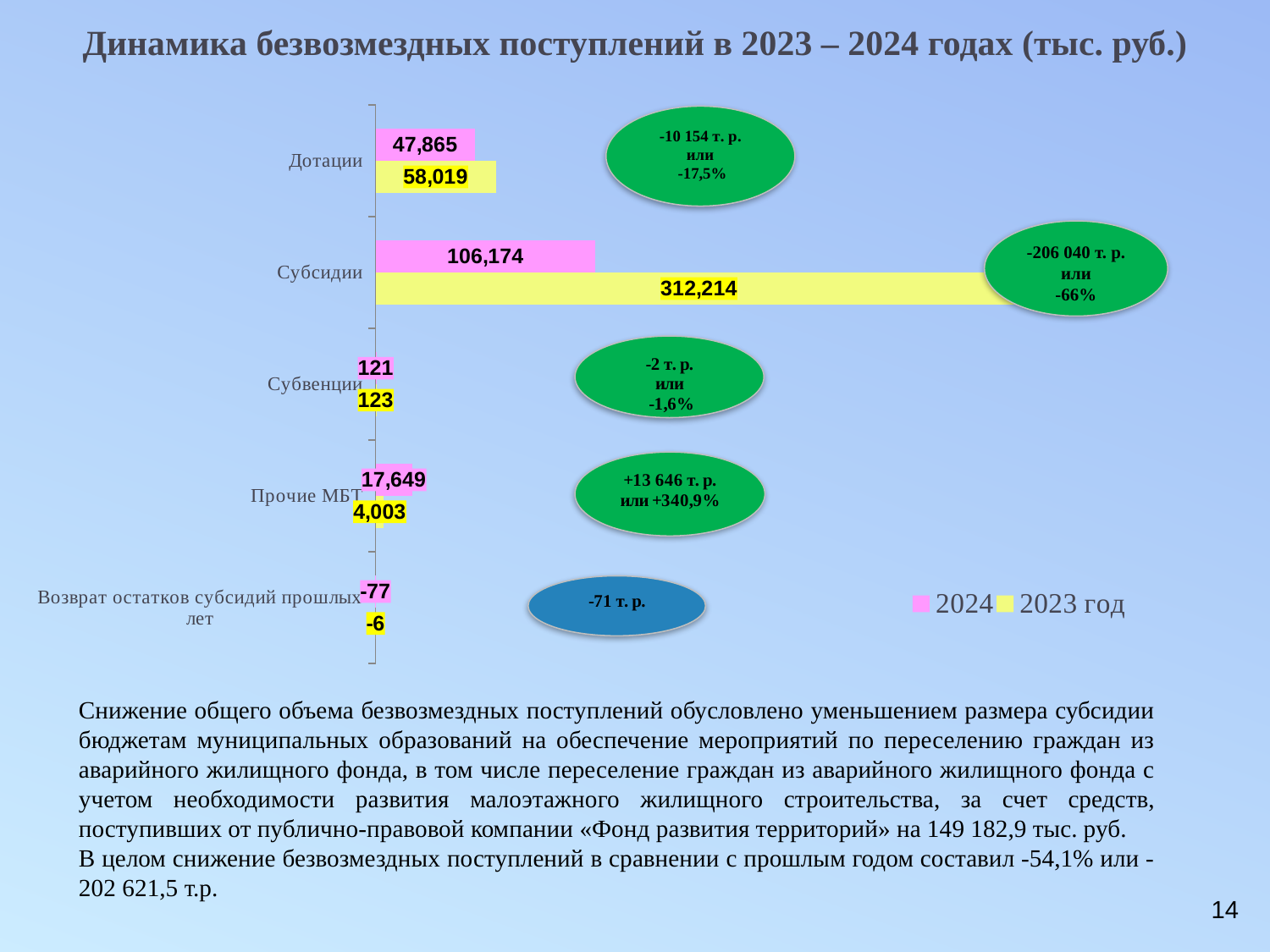
What is the difference between the 2023 and 2024 values for Субсидии? 206,040 What is the 2024 value for Прочие МБТ? 17,649 What is the 2023 value for Дотации? 58,019 How many categories are shown on the chart? 5 How many series does the legend list? 2 For Дотации, which year has the larger value, 2024 or 2023? 2023 What is the 2024 value for Субсидии? 106,174 Which category has the highest 2023 value? Субсидии What kind of chart is shown on the slide? Bar chart Which category has the lowest 2024 value? Возврат остатков субсидий прошлых лет What is the difference between the 2024 and 2023 values for Прочие МБТ? 13,646 What is the 2023 value for Возврат остатков субсидий прошлых лет? -6